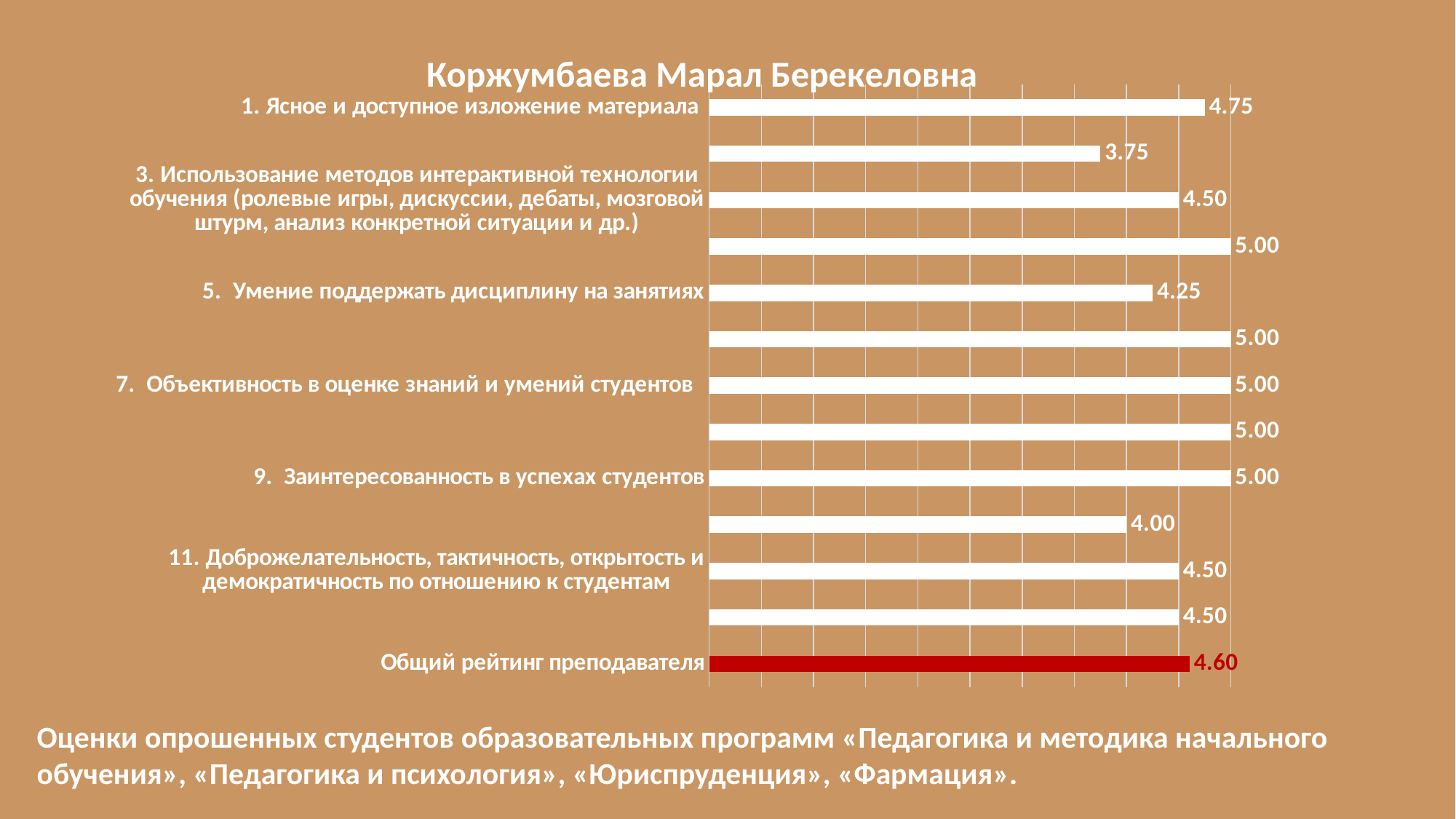
Which is larger: the value for "1. Ясное и доступное изложение материала" or for "11. Доброжелательность, тактичность, открытость и демократичность по отношению к студентам"? 1. Ясное и доступное изложение материала What is the value for "5. Умение поддержать дисциплину на занятиях"? 4.25 What is the value for "7. Объективность в оценке знаний и умений студентов"? 5.00 What is the value for "Общий рейтинг преподавателя"? 4.60 What is the value for "1. Ясное и доступное изложение материала"? 4.75 What is the value for "9. Заинтересованность в успехах студентов"? 5.00 What is the value for "11. Доброжелательность, тактичность, открытость и демократичность по отношению к студентам"? 4.50 How many bars are plotted on the chart? 13 What kind of chart is shown on the slide? Bar chart What is the lowest value shown on the chart? 3.75 What is the title of the chart? Коржумбаева Марал Берекеловна What is the difference between the values for "1. Ясное и доступное изложение материала" and "5. Умение поддержать дисциплину на занятиях"? 0.50